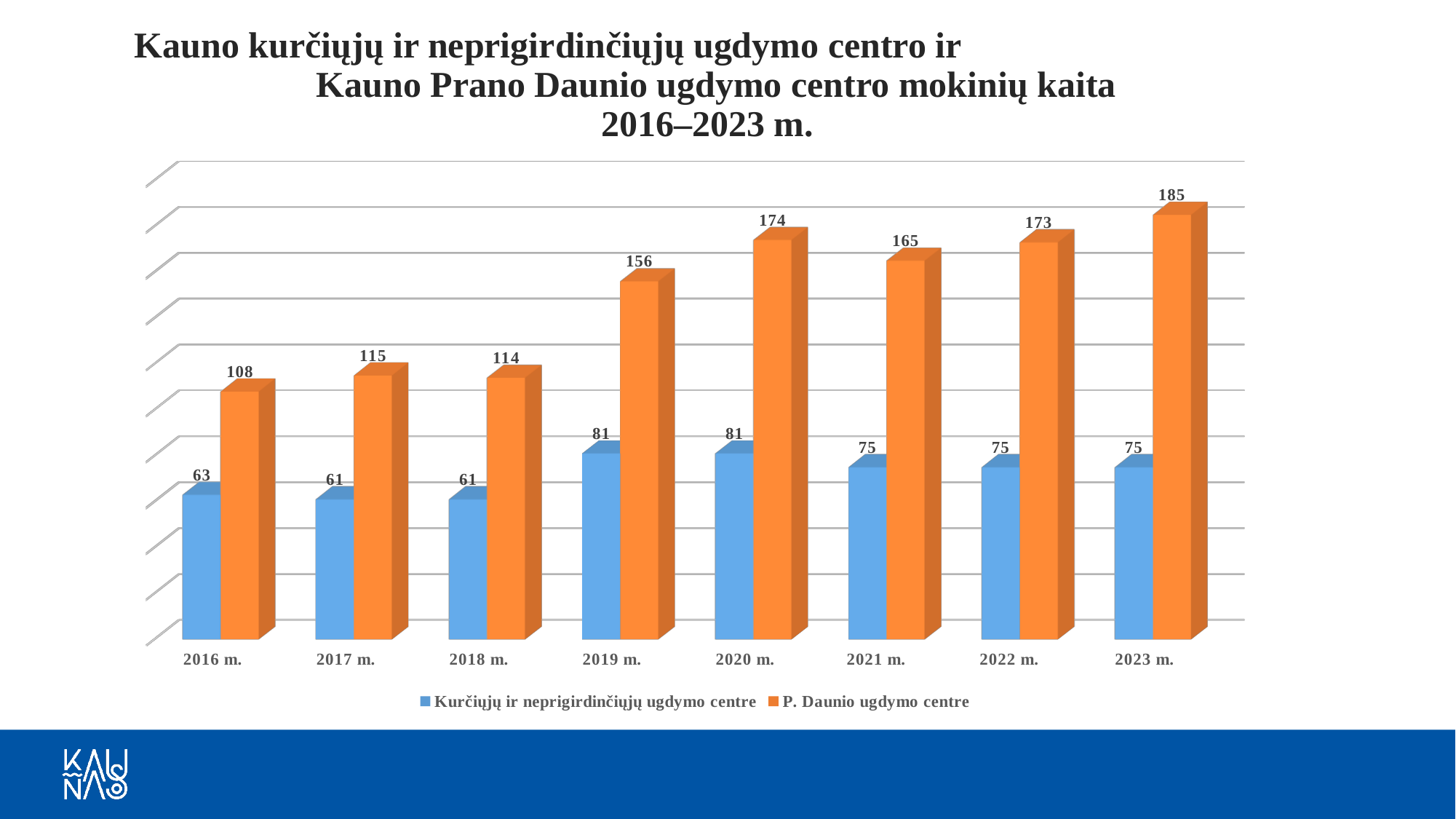
How many years are shown on the x axis? 8 What is the difference between the P. Daunio ugdymo centre values in 2020 m. and 2021 m.? 9 Which is larger in 2018 m.: the value for Kurčiųjų ir neprigirdinčiųjų ugdymo centre or for P. Daunio ugdymo centre? P. Daunio ugdymo centre What is the value for P. Daunio ugdymo centre in 2023 m.? 185 What is the value for Kurčiųjų ir neprigirdinčiųjų ugdymo centre in 2019 m.? 81 Which colour represents P. Daunio ugdymo centre in the chart? Orange What kind of chart is shown on the slide? Bar chart How many series does the legend list? 2 In which year is the value for P. Daunio ugdymo centre highest? 2023 m. What is the difference between the P. Daunio ugdymo centre value and the Kurčiųjų ir neprigirdinčiųjų ugdymo centre value in 2023 m.? 110 What is the value for P. Daunio ugdymo centre in 2016 m.? 108 In which year is the value for P. Daunio ugdymo centre lowest? 2016 m.